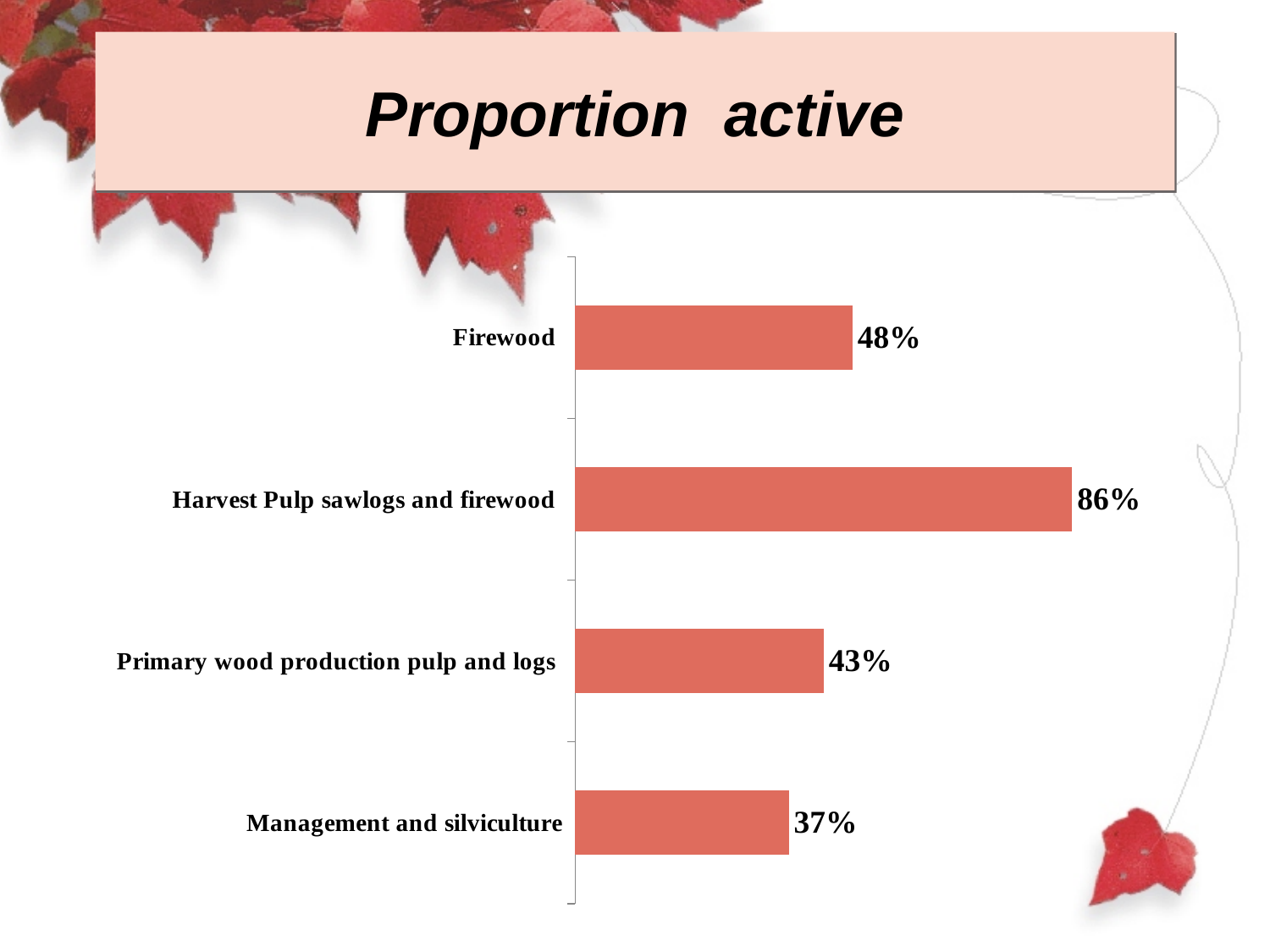
Which category has the highest value? Harvest Pulp sawlogs and firewood What is the value for Primary wood production pulp and logs? 43% Which category has the lowest value? Management and silviculture What is the difference between the values for Harvest Pulp sawlogs and firewood and Firewood? 38% What is the title of the slide? Proportion active What kind of chart is shown on the slide? Bar chart What is the value for Harvest Pulp sawlogs and firewood? 86% What is the difference between the values for Primary wood production pulp and logs and Management and silviculture? 6% What is the value for Firewood? 48% Which is larger, the value for Firewood or the value for Primary wood production pulp and logs? Firewood What is the value for Management and silviculture? 37% How many categories are shown in the chart? 4